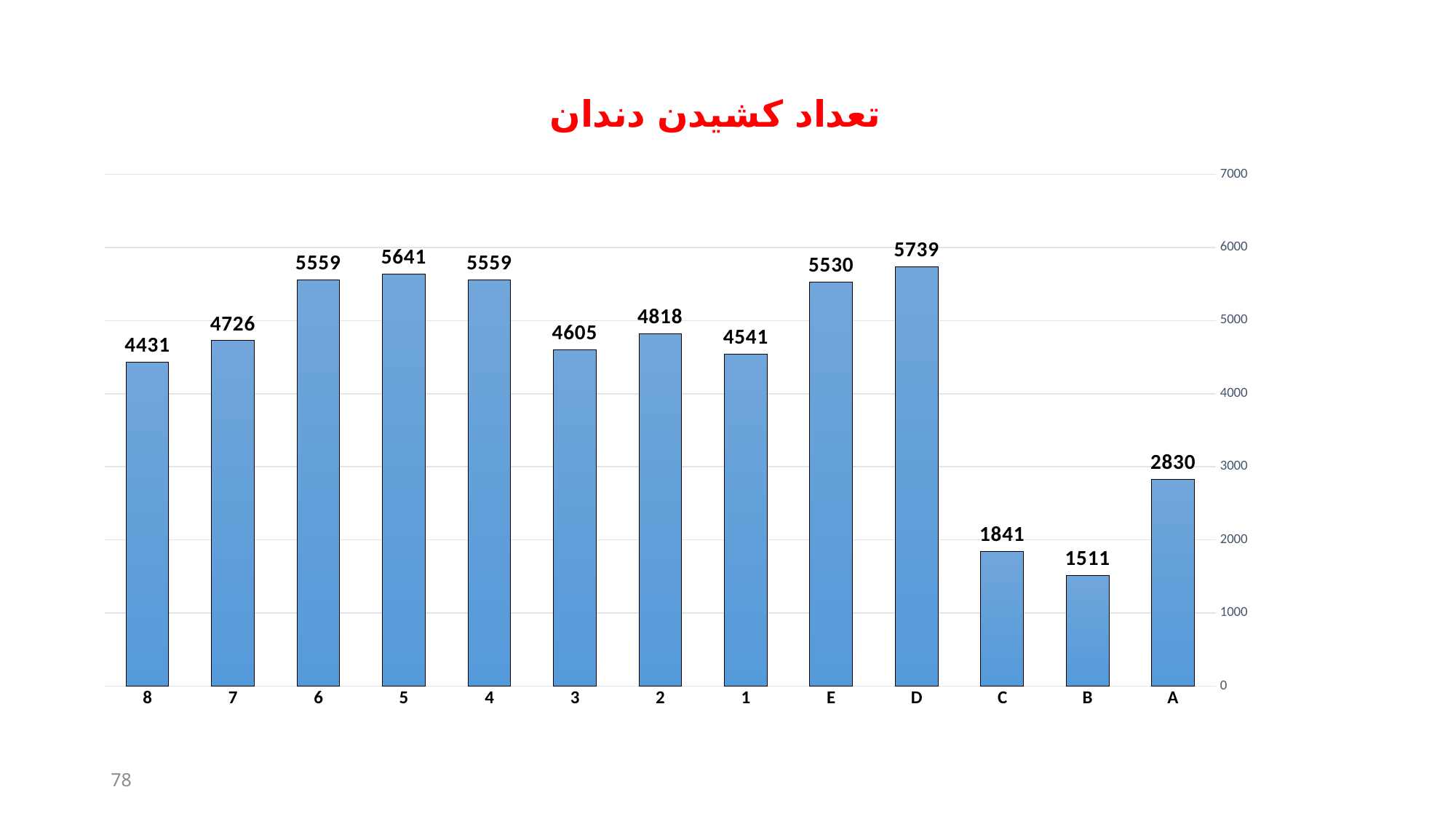
Which is larger, the value for C or the value for A? A What is the highest value shown on the vertical axis? 7000 What is the value for category 5? 5641 Is the value for E greater or less than 5000? greater Which category has the highest value? D What is the value for category A? 2830 How many categories are shown on the x axis? 13 What is the difference between the values for 7 and 8? 295 What is the difference between the values for D and B? 4228 What is the value for category D? 5739 What kind of chart is shown on the slide? bar chart Which category has the lowest value? B